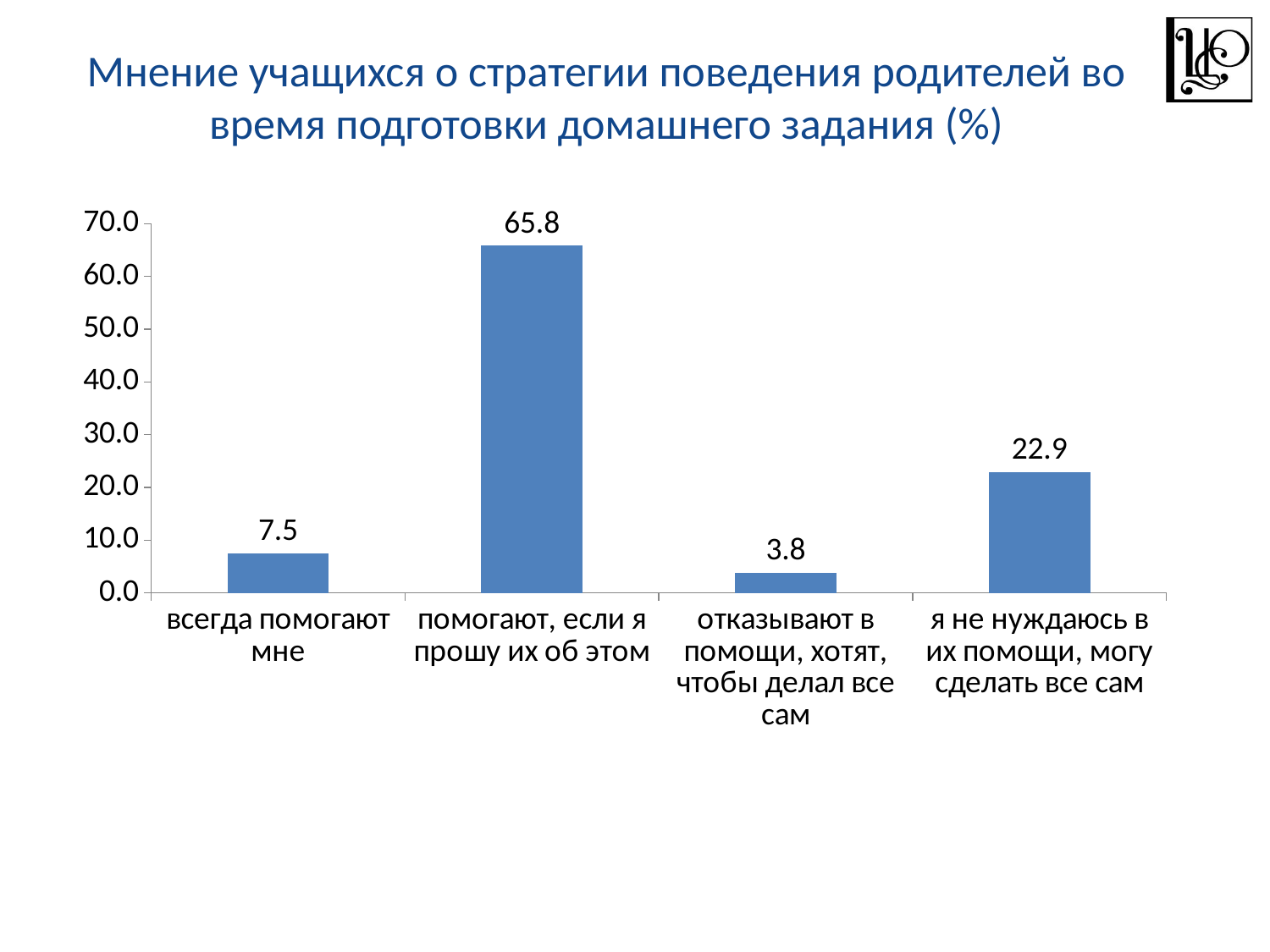
What is the difference between the values for "всегда помогают мне" and "отказывают в помощи, хотят, чтобы делал все сам"? 3.7 What is the value for "всегда помогают мне"? 7.5 What kind of chart is shown on the slide? bar chart What is the difference between the values for "помогают, если я прошу их об этом" and "я не нуждаюсь в их помощи, могу сделать все сам"? 42.9 Which category has the highest value? помогают, если я прошу их об этом What is the value for "отказывают в помощи, хотят, чтобы делал все сам"? 3.8 Which category has the lowest value? отказывают в помощи, хотят, чтобы делал все сам What is the value for "помогают, если я прошу их об этом"? 65.8 How many categories are shown on the chart? 4 Which is larger: the value for "всегда помогают мне" or the value for "я не нуждаюсь в их помощи, могу сделать все сам"? я не нуждаюсь в их помощи, могу сделать все сам What is the value for "я не нуждаюсь в их помощи, могу сделать все сам"? 22.9 Is the value for "помогают, если я прошу их об этом" greater or less than 60.0? greater